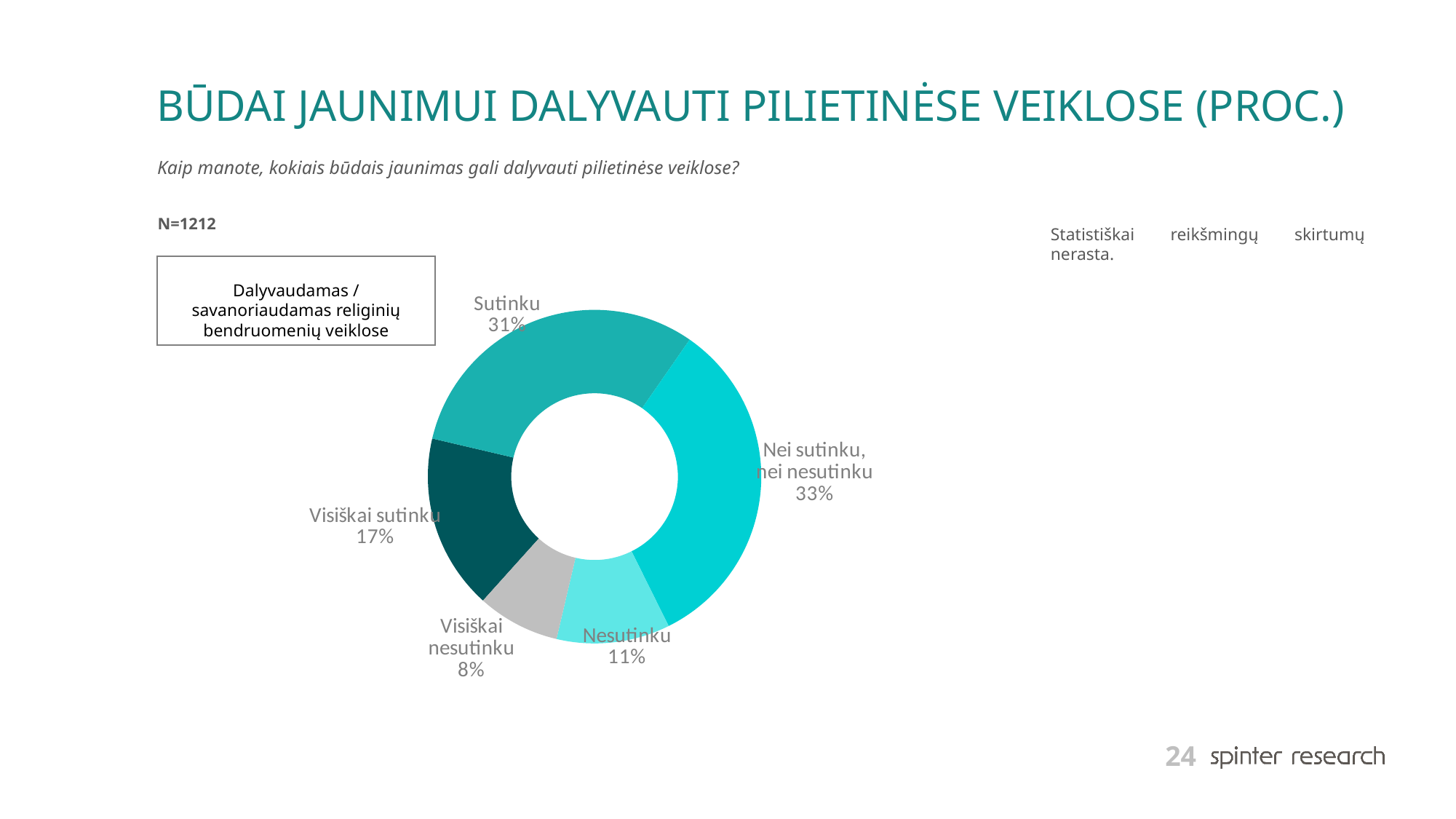
What percentage of respondents answered "Visiškai nesutinku"? 8% What kind of chart is shown on the slide? Pie chart (donut) What percentage of respondents answered "Nei sutinku, nei nesutinku"? 33% What is the sample size (N) stated on the slide? N=1212 What percentage of respondents answered "Sutinku"? 31% What percentage of respondents answered "Visiškai sutinku"? 17% What is the combined share of "Sutinku" and "Visiškai sutinku"? 48% What is the difference in percentage points between "Visiškai sutinku" and "Nesutinku"? 6 Which response category has the largest share of the pie? Nei sutinku, nei nesutinku Which response category has the smallest share of the pie? Visiškai nesutinku How many response categories are shown in the chart? 5 Which is larger, the share for "Sutinku" or the share for "Visiškai sutinku"? Sutinku